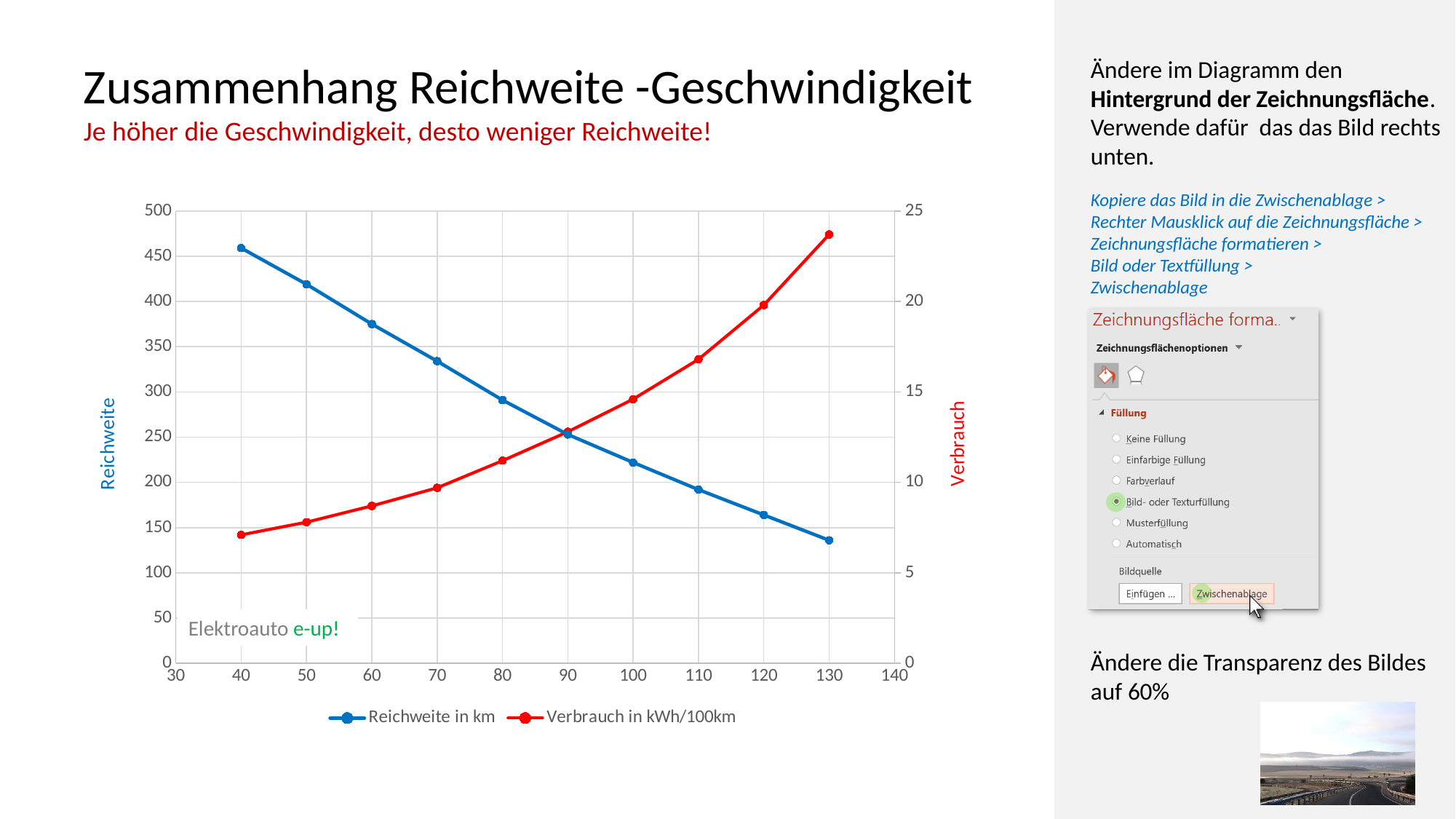
What is the title of the left vertical axis? Reichweite At which x-axis value is Verbrauch in kWh/100km highest? 130 At which x-axis value is Reichweite in km highest? 40 What kind of chart is shown on the slide? line chart How many series does the legend list? 2 Is the Reichweite in km value at x = 40 greater or less than 400? greater Is the Verbrauch in kWh/100km value at x = 130 greater or less than 20? greater At which x-axis value is Reichweite in km lowest? 130 How many data points does the Reichweite in km series have? 10 Does the Reichweite in km series rise or fall as the x-axis value increases? fall Is the Reichweite in km value at x = 130 greater or less than 150? less Does the Verbrauch in kWh/100km series rise or fall as the x-axis value increases? rise